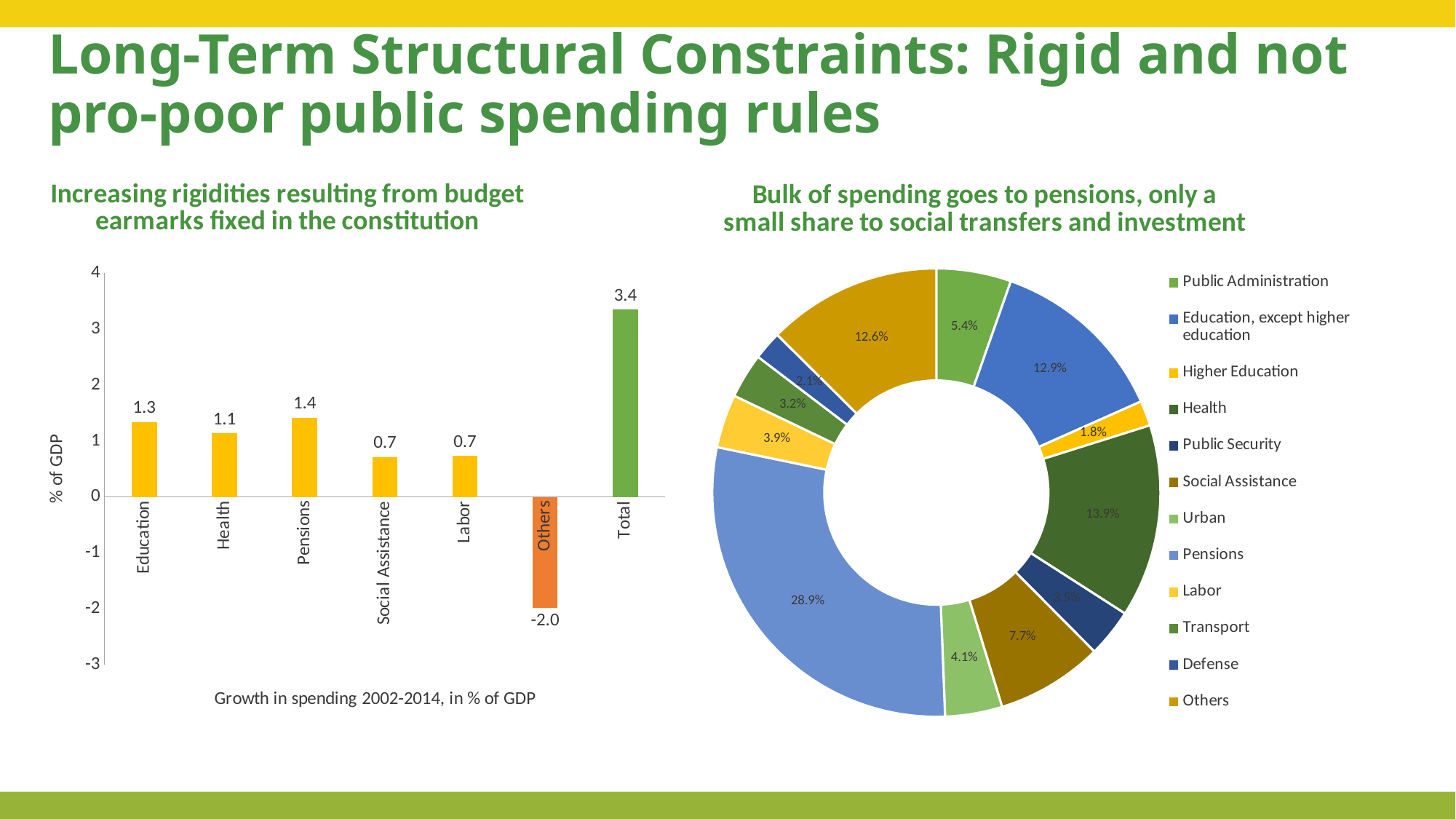
How many entries does the legend of the right chart (Bulk of spending goes to pensions) list? 12 In the left chart (Growth in spending 2002-2014), which category has the lowest value? Others In the left chart (Growth in spending 2002-2014), how many categories are shown on the x axis? 7 In the right chart (Bulk of spending goes to pensions), which category has the smallest share? Higher Education What kind of chart is the left chart (Growth in spending 2002-2014)? Bar chart In the right chart (Bulk of spending goes to pensions), which is larger: the share for Social Assistance or the share for Urban? Social Assistance In the left chart (Growth in spending 2002-2014), what is the value for Pensions? 1.4 In the right chart (Bulk of spending goes to pensions), what share goes to Health? 13.9% In the right chart (Bulk of spending goes to pensions), what share goes to Pensions? 28.9% In the left chart (Growth in spending 2002-2014), what is the difference between the values for Education and Health? 0.2 In the left chart (Growth in spending 2002-2014), excluding Total, which category has the highest value? Pensions In the left chart (Growth in spending 2002-2014), what is the value for Others? -2.0